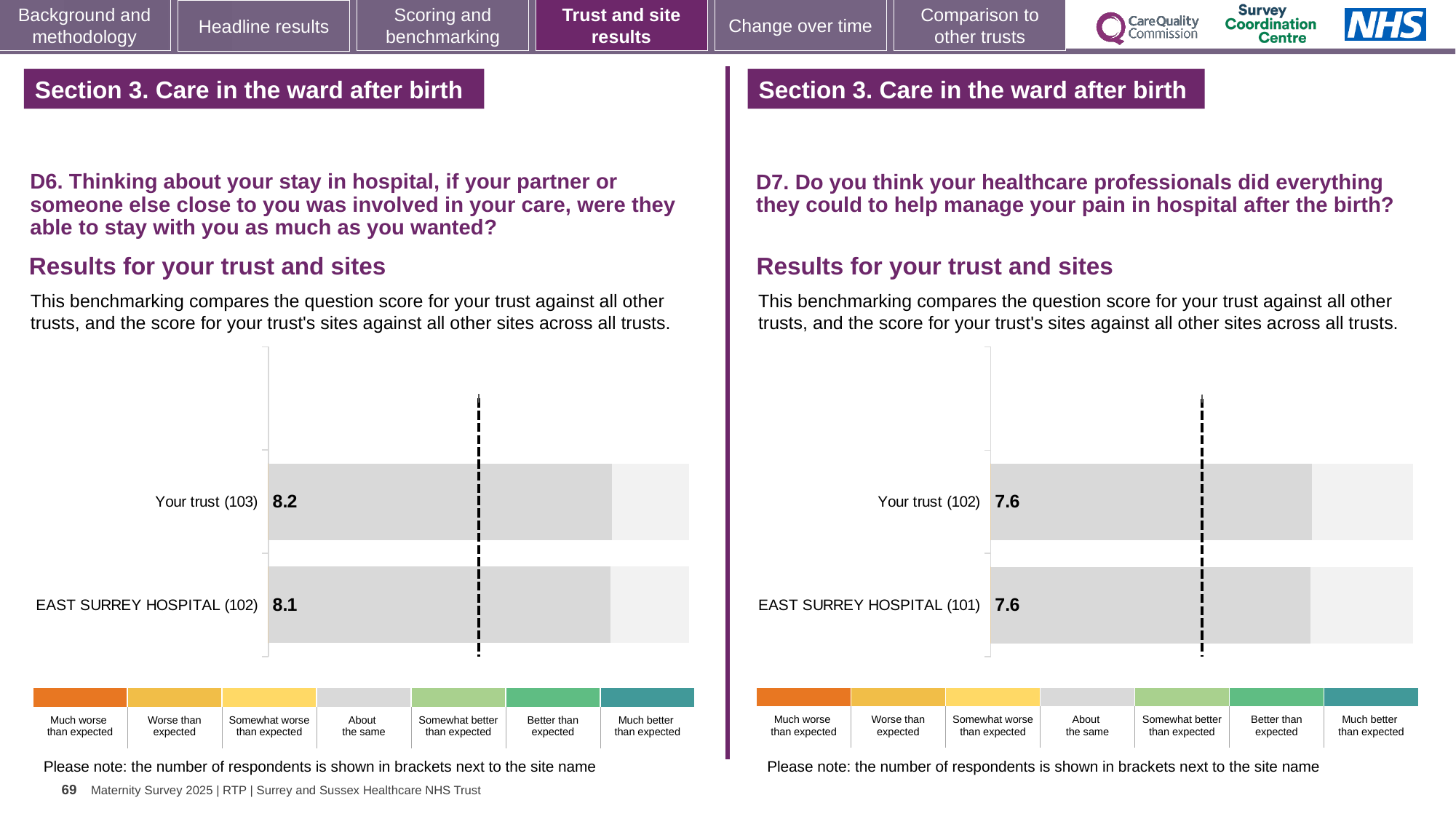
In the D7 chart on the right, what is the score for Your trust (102)? 7.6 How many respondents are shown in brackets for EAST SURREY HOSPITAL in the D7 chart on the right? 101 In the D7 chart on the right, what is the difference between the score for Your trust and the score for EAST SURREY HOSPITAL? 0 How many bars are plotted in the D6 chart on the left? 2 In the D6 chart on the left, what is the score for EAST SURREY HOSPITAL (102)? 8.1 In the D7 chart on the right, what is the score for EAST SURREY HOSPITAL (101)? 7.6 In the D6 chart on the left, what is the score for Your trust (103)? 8.2 How many benchmark categories are shown in the colour key below the D6 chart on the left? 7 In the D6 chart on the left, what is the difference between the score for Your trust and the score for EAST SURREY HOSPITAL? 0.1 In the D6 chart on the left, which has the higher score, Your trust or EAST SURREY HOSPITAL? Your trust What type of chart is used for the D6 results on the left? Bar chart How many bars are plotted in the D7 chart on the right? 2